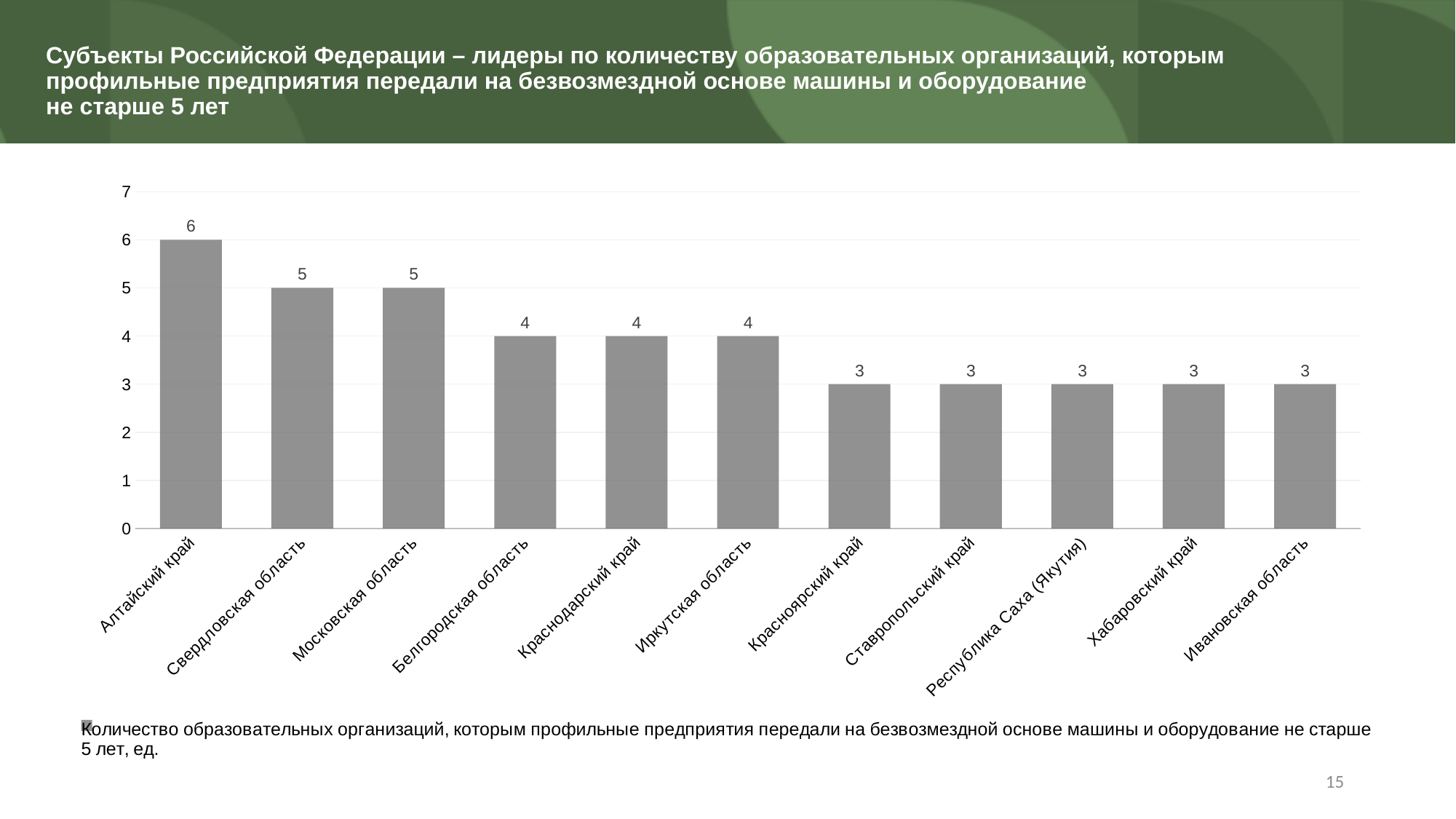
How many regions are shown on the chart? 11 What is the value for Белгородская область? 4 Do the values rise or fall from left to right along the x axis? fall What is the value for Хабаровский край? 3 What is the difference between the values for Свердловская область and Краснодарский край? 1 What kind of chart is shown on the slide? bar chart What is the value for Алтайский край? 6 How many regions have a value of 3? 5 Which region has the highest value? Алтайский край What is the difference between the values for Алтайский край and Ивановская область? 3 What is the value for Московская область? 5 Which is larger, the value for Иркутская область or the value for Красноярский край? Иркутская область